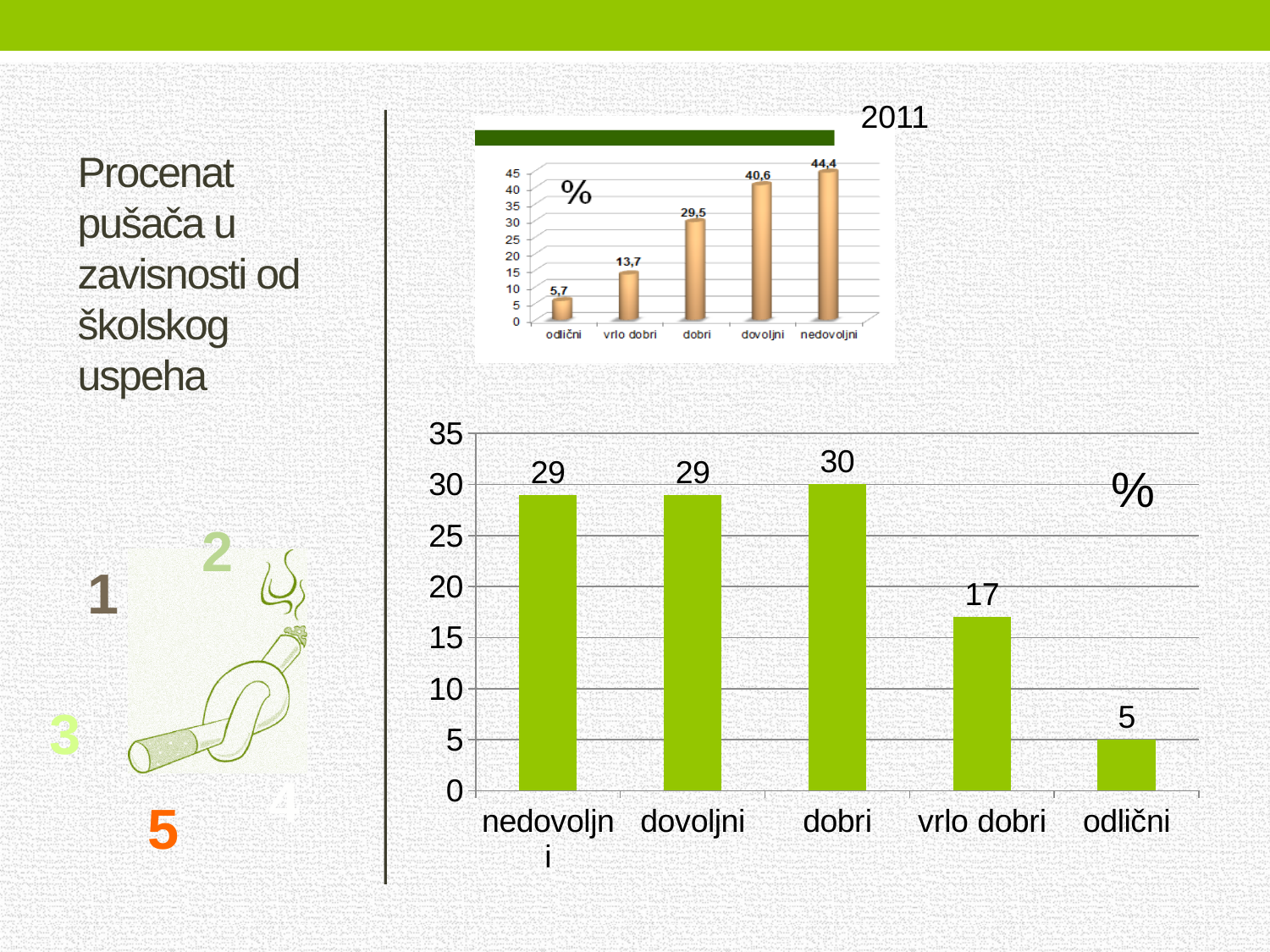
What kind of chart is the bottom chart? bar chart In the bottom chart, what is the difference between the values for dobri and vrlo dobri? 13 In the bottom chart, what is the value for dobri? 30 In the top chart labelled 2011, what is the value for nedovoljni? 44,4 In the top chart labelled 2011, do the values rise or fall from odlični to nedovoljni along the x axis? rise In the bottom chart, is the value for dovoljni greater or less than 25? greater In the bottom chart, which category has the lowest value? odlični In the bottom chart, what is the value for odlični? 5 In the bottom chart, how many categories are shown on the x axis? 5 In the top chart labelled 2011, what is the value for vrlo dobri? 13,7 In the top chart labelled 2011, which category has the highest value? nedovoljni In the bottom chart, what is the value for vrlo dobri? 17